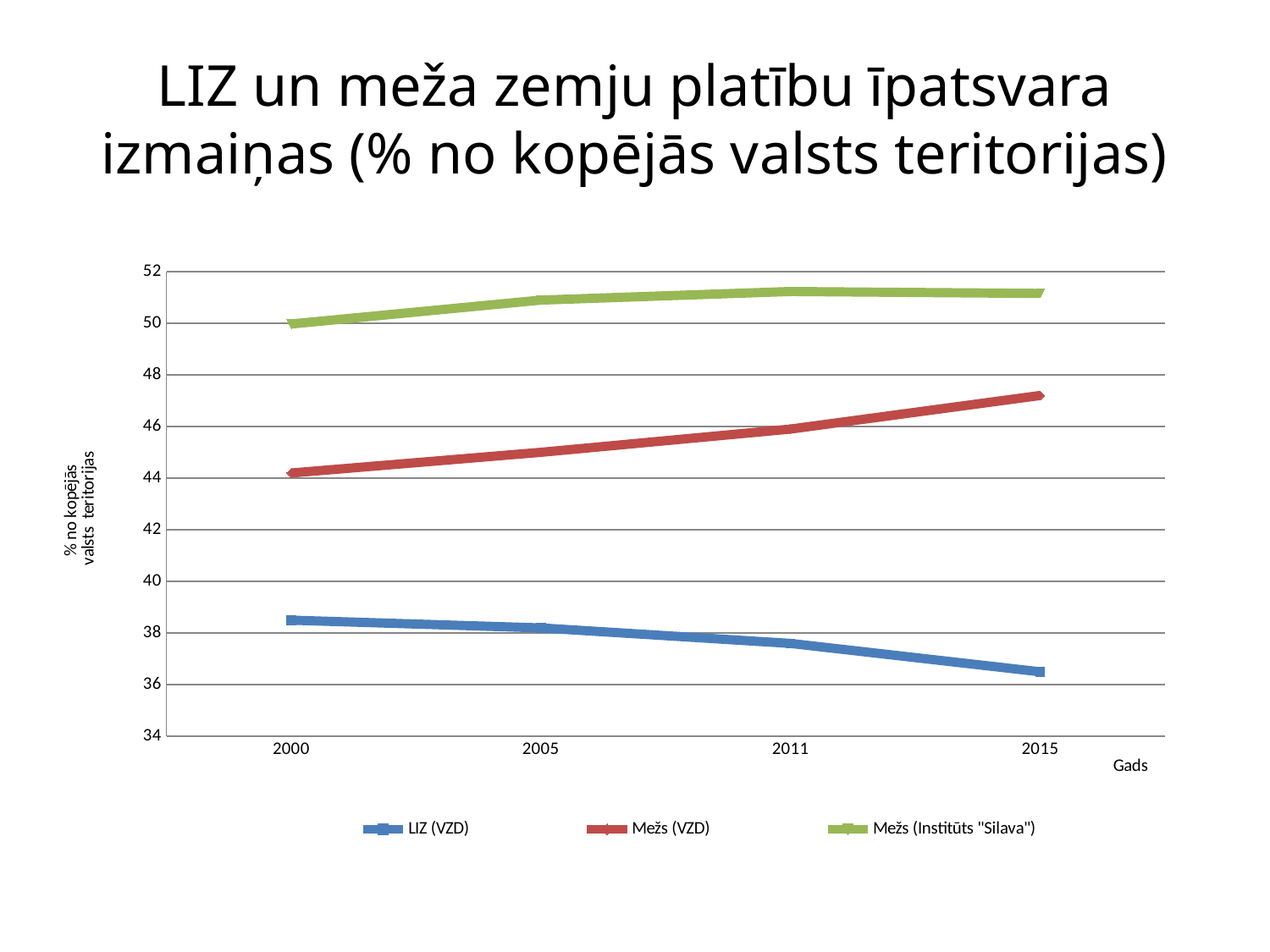
Does the Mežs (VZD) series rise or fall from 2000 to 2015? rise Is the value for Mežs (VZD) in 2015 greater or less than 46? greater Does the LIZ (VZD) series rise or fall from 2000 to 2015? fall What kind of chart is shown on the slide? line chart Which series has the highest value in 2015? Mežs (Institūts "Silava") How many years are plotted along the x axis? 4 What is the label of the x axis? Gads Is the value for Mežs (Institūts "Silava") in 2011 greater or less than 50? greater Which series has the lowest value in 2000? LIZ (VZD) Is the value for LIZ (VZD) in 2000 greater or less than 38? greater How many series does the legend list? 3